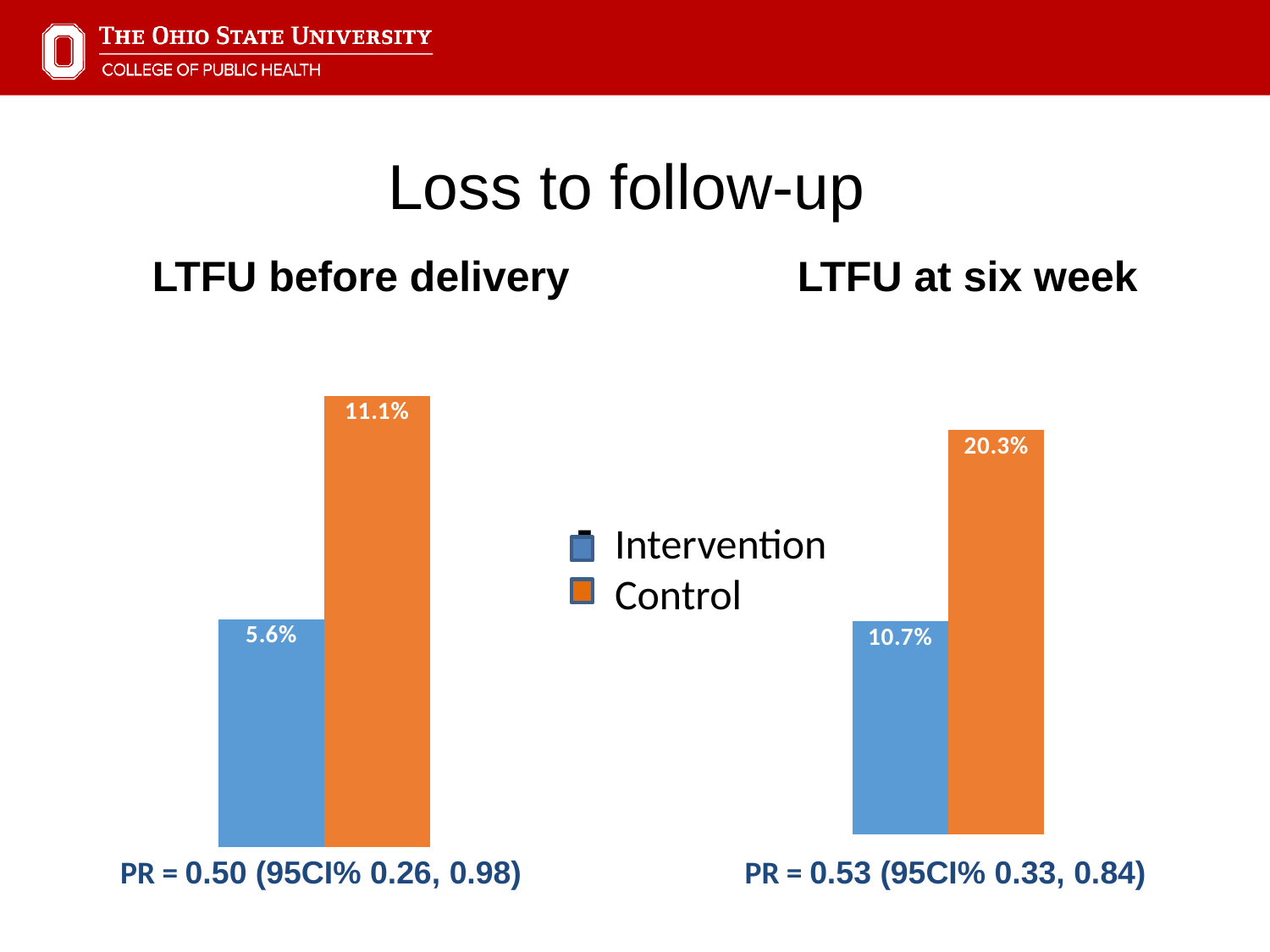
How many series does the legend list? 2 In the 'LTFU at six week' chart, what is the difference between the Control and Intervention values? 9.6% In the 'LTFU before delivery' chart, what is the value for Control? 11.1% In the 'LTFU at six week' chart, which group has the lower value? Intervention Which colour represents the Control group in the charts? orange In the 'LTFU before delivery' chart, what is the value for Intervention? 5.6% In the 'LTFU at six week' chart, what is the value for Control? 20.3% Is the Intervention value in the 'LTFU at six week' chart larger or smaller than the Control value in the 'LTFU before delivery' chart? smaller In the 'LTFU before delivery' chart, which group has the higher value? Control In the 'LTFU before delivery' chart, what is the difference between the Control and Intervention values? 5.5% In the 'LTFU at six week' chart, what is the value for Intervention? 10.7% What kind of chart is the 'LTFU before delivery' chart? bar chart